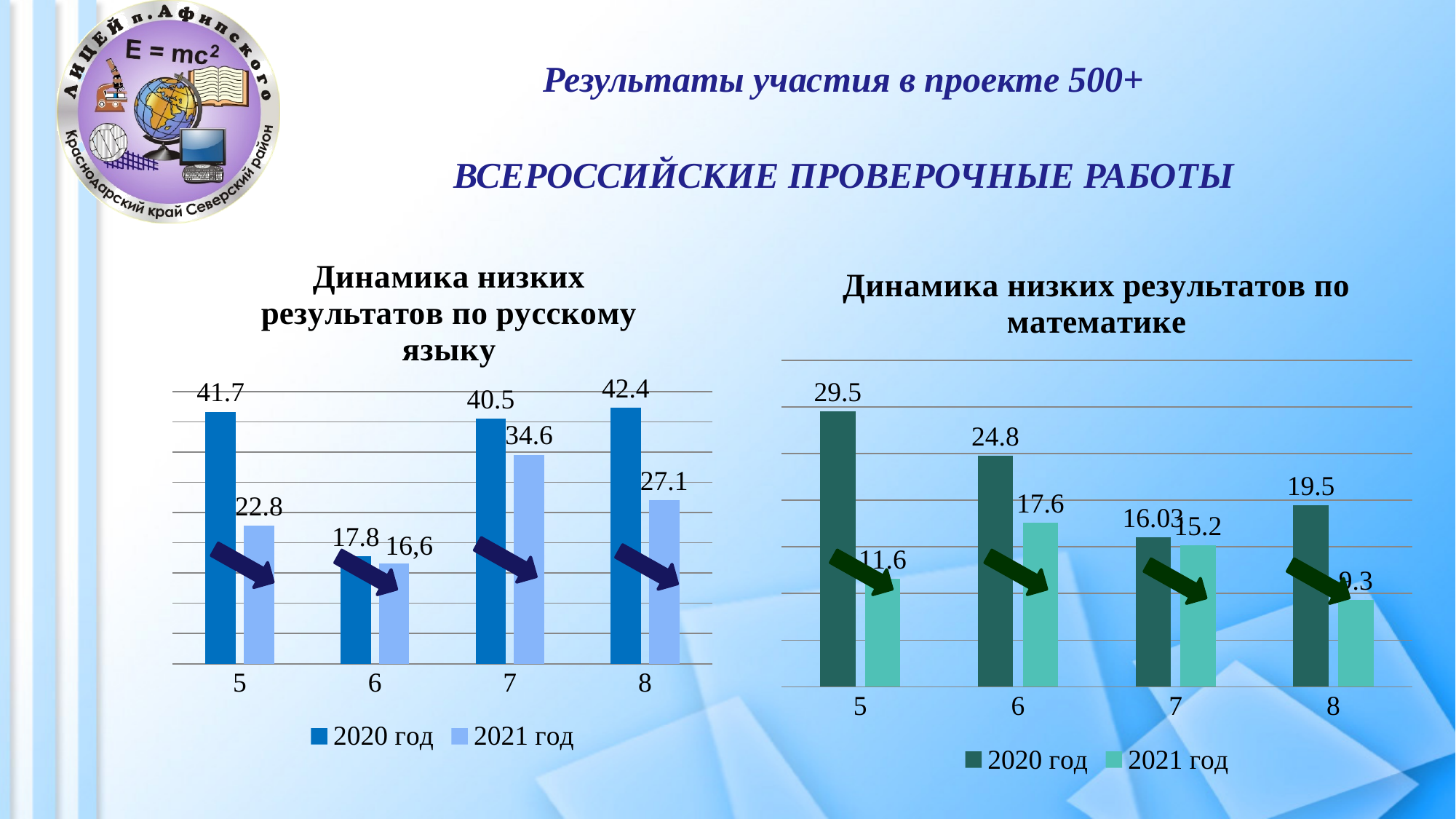
In the chart 'Динамика низких результатов по математике', what is the value for grade 8 in the 2021 год series? 9.3 In the chart 'Динамика низких результатов по русскому языку', what is the value for grade 6 in the 2021 год series? 16,6 In the chart 'Динамика низких результатов по русскому языку', what is the value for grade 5 in the 2020 год series? 41.7 In the chart 'Динамика низких результатов по русскому языку', which grade has the highest value in the 2020 год series? 8 In the chart 'Динамика низких результатов по математике', which is larger for grade 6: the 2020 год value or the 2021 год value? 2020 год In the chart 'Динамика низких результатов по русскому языку', what is the difference between the 2020 год and 2021 год values for grade 8? 15.3 In the chart 'Динамика низких результатов по математике', what is the difference between the 2020 год and 2021 год values for grade 5? 17.9 How many grade categories are shown on the x axis of the chart 'Динамика низких результатов по математике'? 4 In the chart 'Динамика низких результатов по математике', what is the value for grade 7 in the 2020 год series? 16.03 In the chart 'Динамика низких результатов по русскому языку', how many series does the legend list? 2 What type of chart is 'Динамика низких результатов по русскому языку'? Bar chart In the chart 'Динамика низких результатов по математике', which grade has the lowest value in the 2021 год series? 8